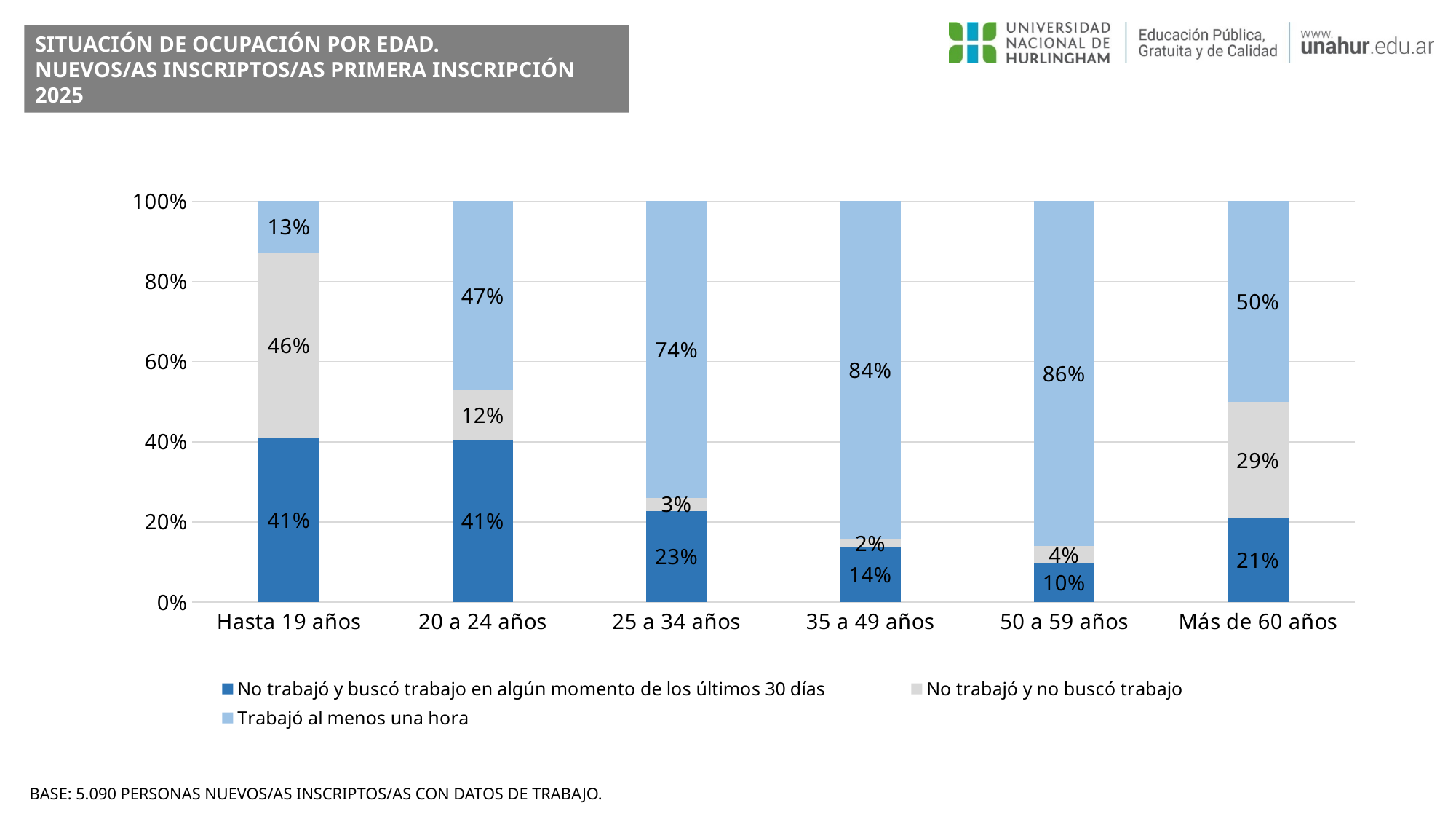
What is the base (number of people) stated at the bottom of the slide? 5.090 What kind of chart is shown on the slide? Stacked bar chart Which age group has the highest share for 'Trabajó al menos una hora'? 50 a 59 años What percentage of the '50 a 59 años' group 'Trabajó al menos una hora'? 86% What percentage of the 'Más de 60 años' group 'No trabajó y no buscó trabajo'? 29% Which is larger: the 'No trabajó y no buscó trabajo' share for 'Hasta 19 años' or for 'Más de 60 años'? Hasta 19 años What percentage of the 'Hasta 19 años' group 'Trabajó al menos una hora'? 13% How many age groups are shown on the x axis? 6 What is the difference between the 'Trabajó al menos una hora' shares for '35 a 49 años' and '20 a 24 años'? 37% How many series does the legend list? 3 What percentage of the '25 a 34 años' group 'No trabajó y buscó trabajo en algún momento de los últimos 30 días'? 23% Which age group has the lowest share for 'No trabajó y buscó trabajo en algún momento de los últimos 30 días'? 50 a 59 años